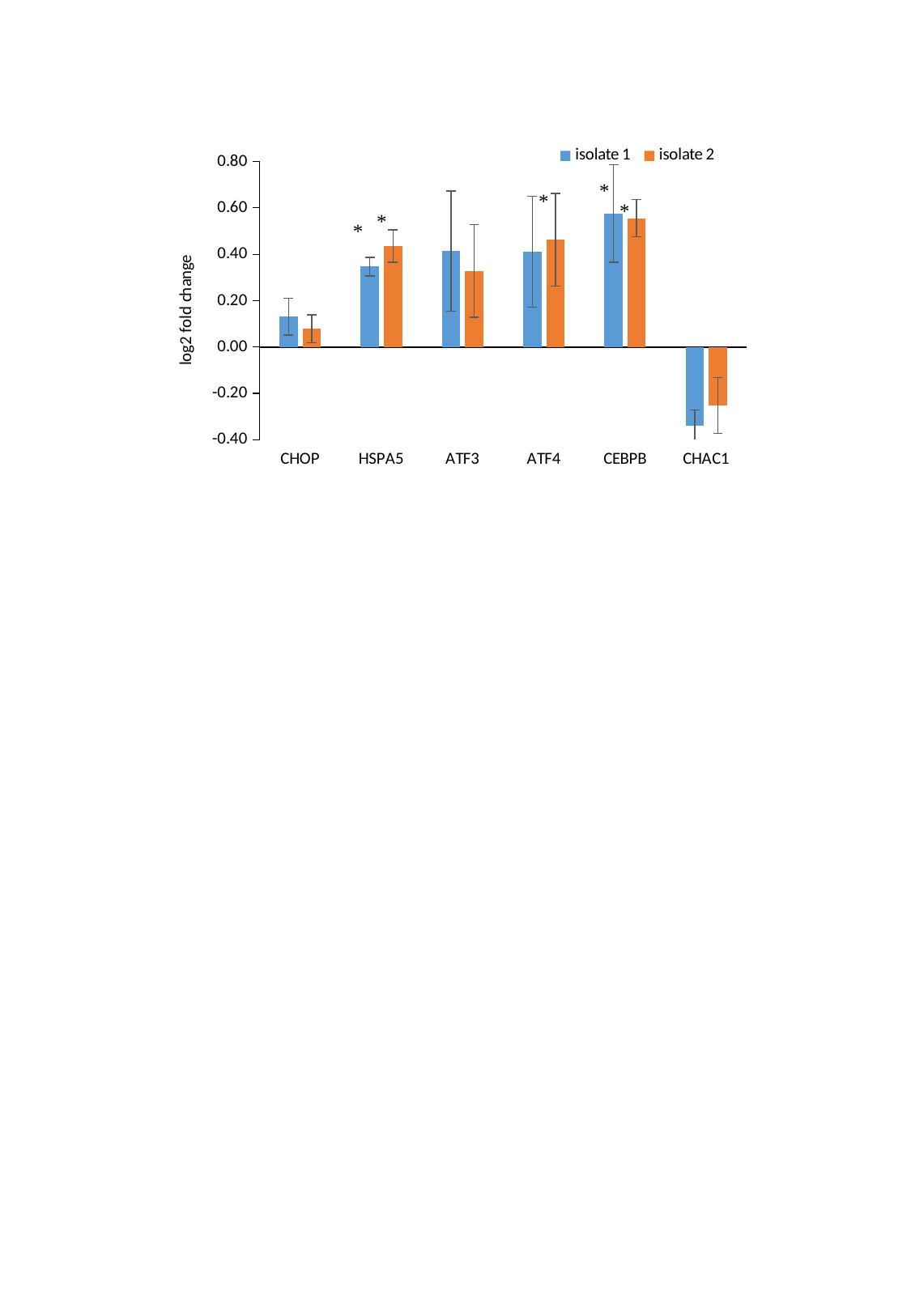
How many series does the legend list? 2 What kind of chart is shown on the slide? bar chart For ATF3, which series has the larger value, isolate 1 or isolate 2? isolate 1 Which category has the highest value for isolate 1? CEBPB Is the value for isolate 1 at CHOP greater or less than 0.20? less How many gene categories are shown on the x axis? 6 For HSPA5, which series has the larger value, isolate 1 or isolate 2? isolate 2 Is the value for isolate 1 at CEBPB greater or less than 0.40? greater What is the label on the y axis? log2 fold change Which category has the lowest value for isolate 2? CHAC1 Which category has the lowest value for isolate 1? CHAC1 Is the value for isolate 1 at CHAC1 greater or less than -0.20? less